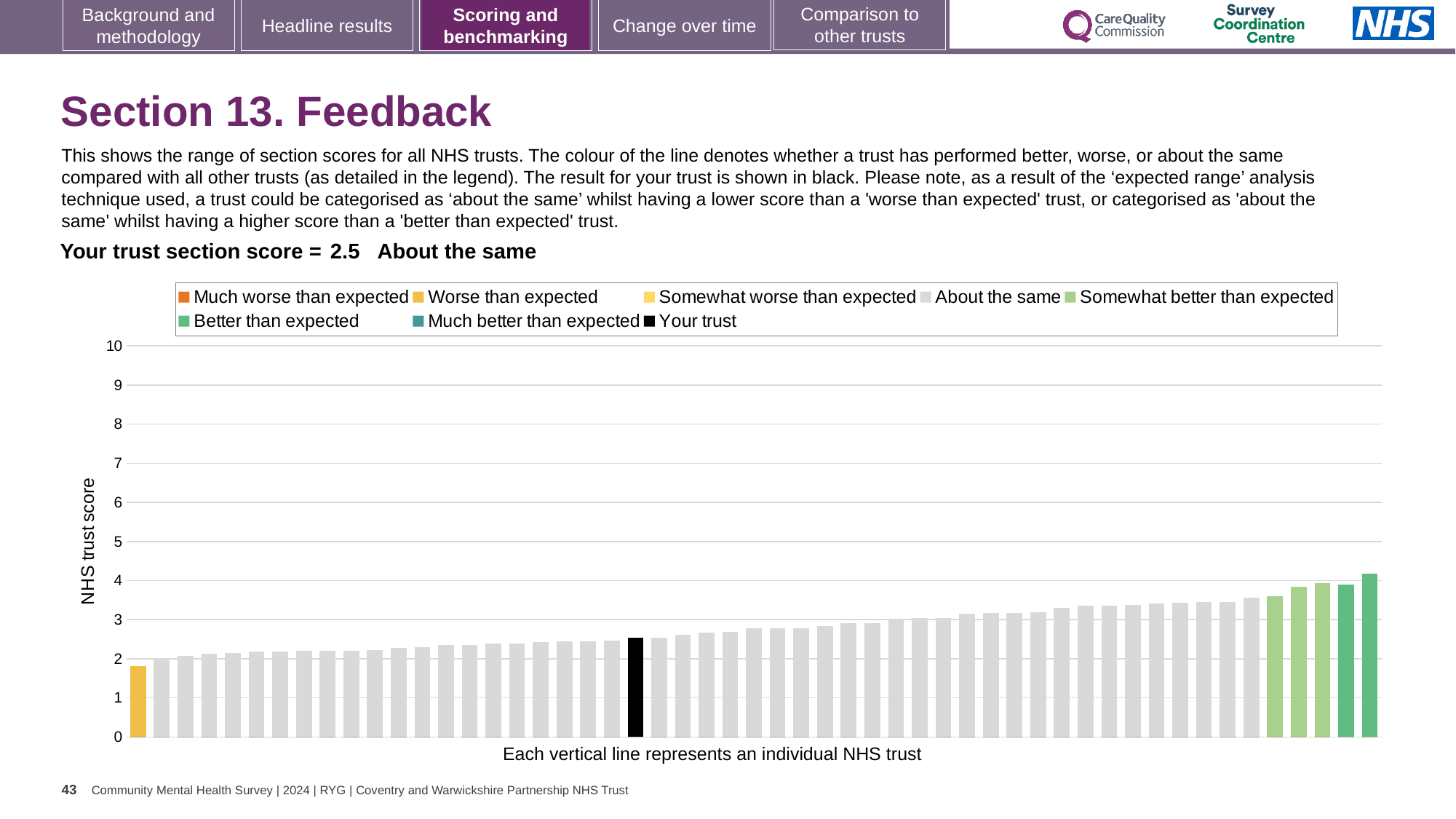
What is the label on the vertical axis of the chart? NHS trust score Which performance category is your trust placed in for this section? About the same How many trusts are shown in yellow as 'Worse than expected'? 1 Is the score for your trust (black bar) greater or less than 2? greater Is the score of the leftmost (yellow) bar greater or less than 3? less Do the trust scores rise or fall from left to right across the chart? rise How many entries does the chart legend list? 8 What is the section score for your trust shown on the slide? 2.5 What kind of chart is shown on the slide? bar chart Is the highest trust score on the chart greater or less than 5? less